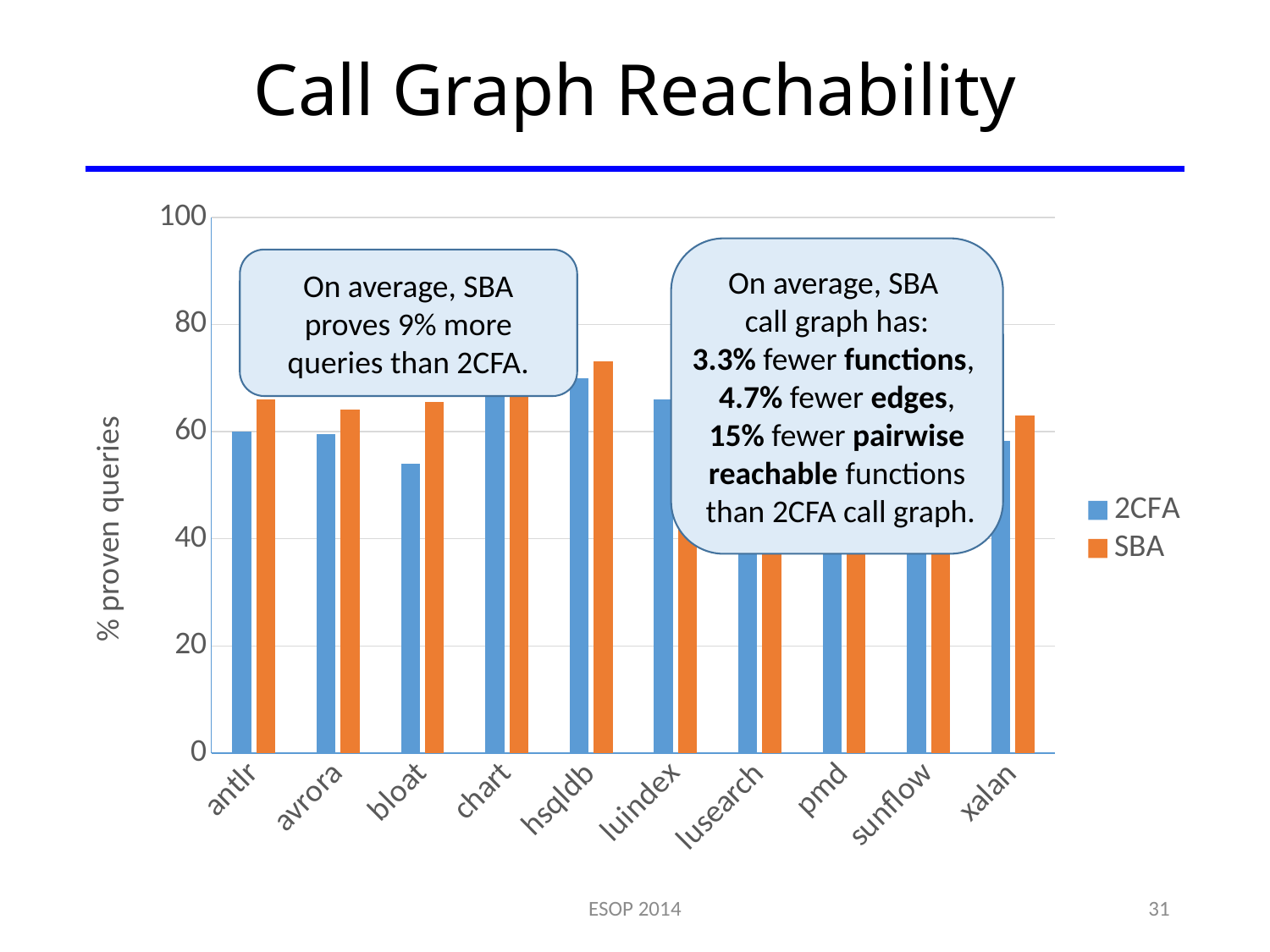
How many series does the legend list? 2 Is the 2CFA value for hsqldb greater or less than 60? greater For antlr, which series has the larger value, 2CFA or SBA? SBA How many benchmark categories are shown on the x axis? 10 For bloat, which series has the larger value, 2CFA or SBA? SBA Is the 2CFA value for bloat greater or less than 60? less Is the SBA value for xalan greater or less than 80? less Which series is shown in orange? SBA What kind of chart is shown on the slide? bar chart What is the label of the y axis? % proven queries